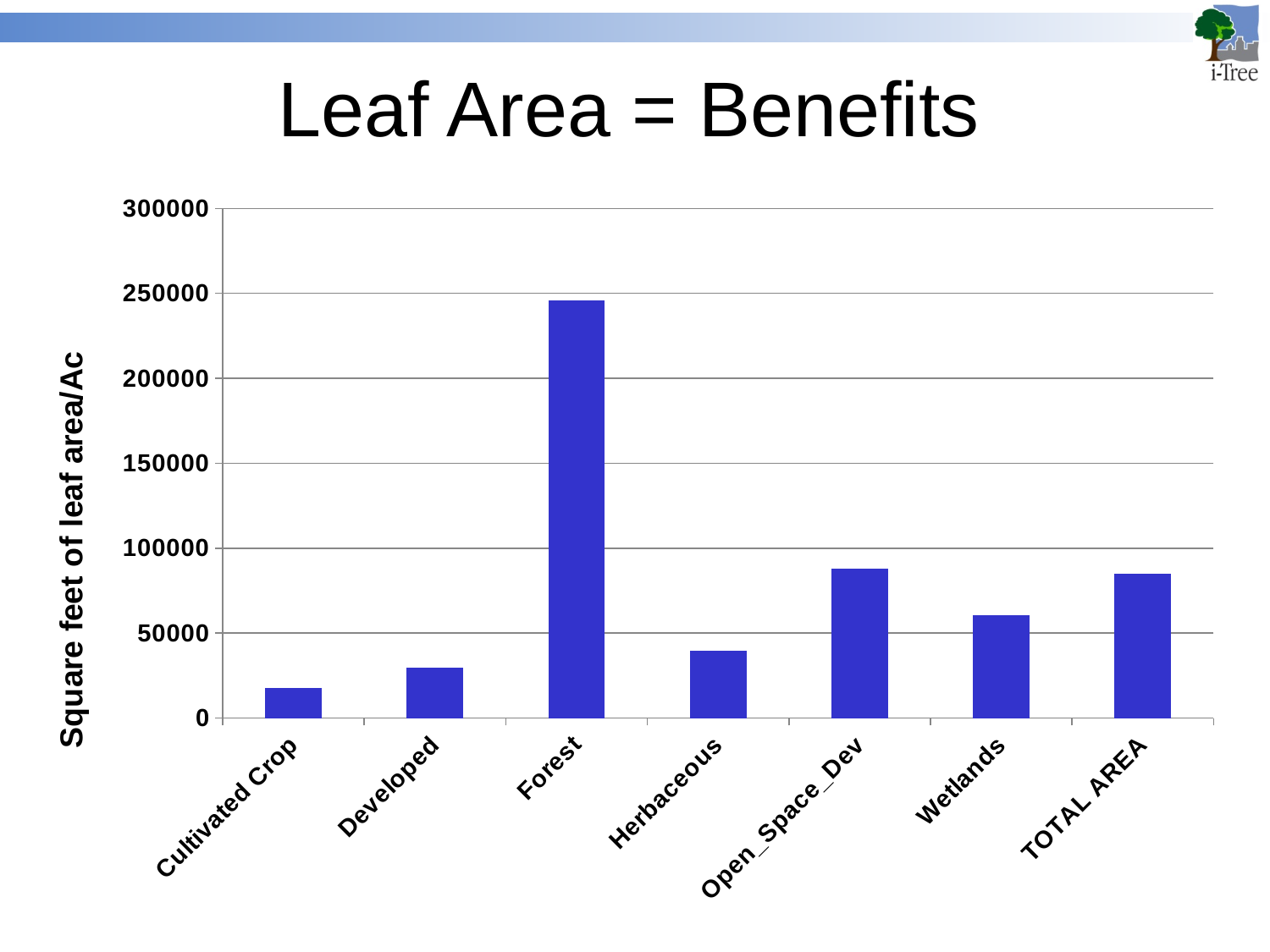
Which is larger, the value for Open_Space_Dev or the value for Herbaceous? Open_Space_Dev Is the value for Forest greater or less than 200000? greater Which category has the lowest square feet of leaf area per acre? Cultivated Crop Is the value for Open_Space_Dev greater or less than 100000? less What is the label on the y axis of the chart? Square feet of leaf area/Ac Which category has the highest square feet of leaf area per acre? Forest Is the value for Wetlands greater or less than 50000? greater Which is larger, the value for Developed or the value for Cultivated Crop? Developed How many categories are shown on the x axis of the chart? 7 What kind of chart is shown on the slide? bar chart